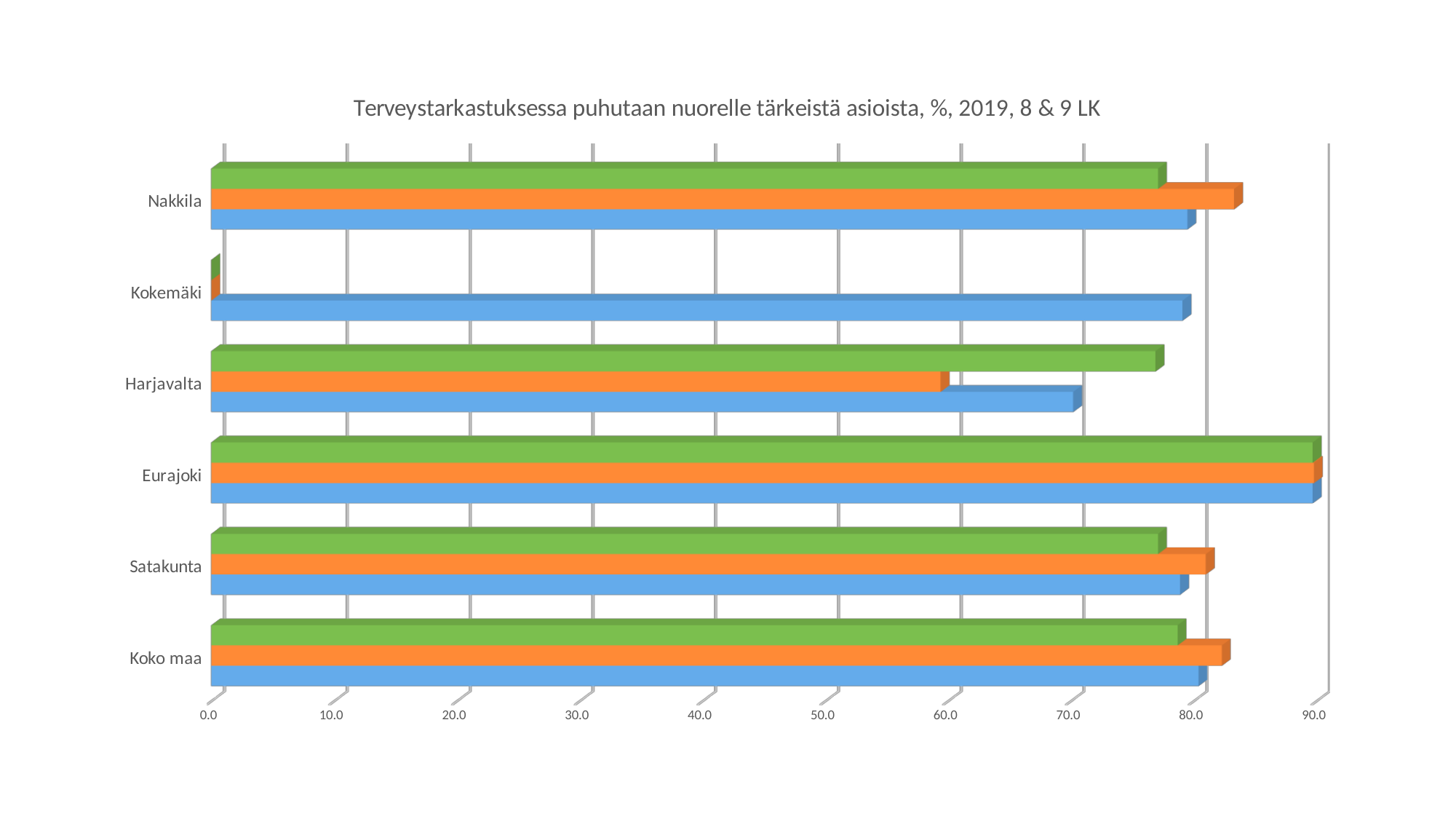
Which category has the longest green bar? Eurajoki What is the title of the chart? Terveystarkastuksessa puhutaan nuorelle tärkeistä asioista, %, 2019, 8 & 9 LK Is the blue bar for Harjavalta longer or shorter than the blue bar for Kokemäki? shorter How many categories (areas) are shown on the vertical axis of the chart? 6 Is the value of the green bar for Satakunta greater or less than 80? less Which category has the shortest green bar? Kokemäki What kind of chart is shown on the slide? bar chart Is the value of the orange bar for Nakkila greater or less than 80? greater Is the value of the green bar for Harjavalta greater or less than 70? greater Which category has the shortest blue bar? Harjavalta Which category has the longest orange bar? Eurajoki Is the orange bar for Nakkila longer or shorter than the orange bar for Harjavalta? longer